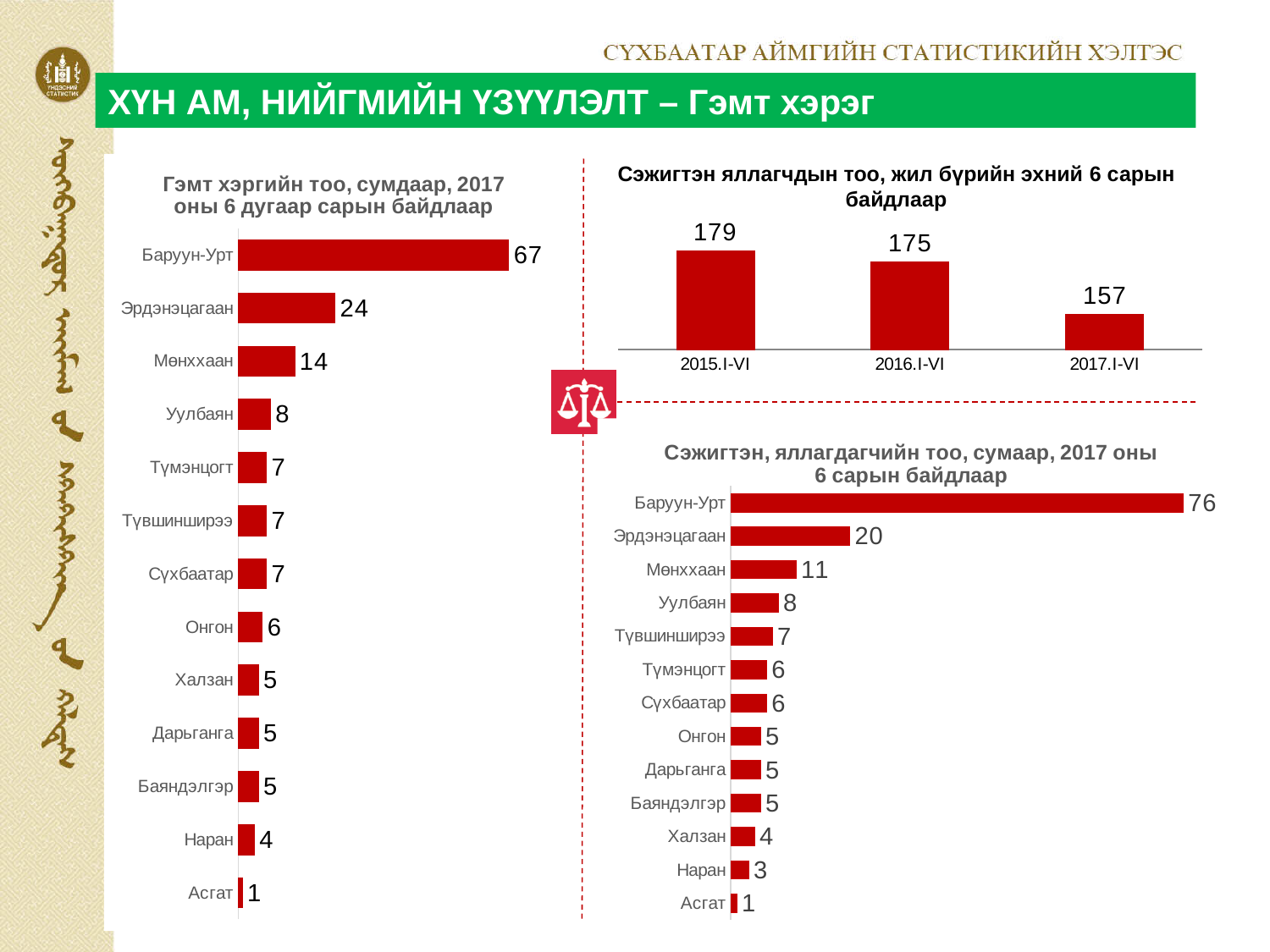
In the left chart 'Гэмт хэргийн тоо, сумдаар', how many sums are listed? 13 In the top right chart 'Сэжигтэн яллагчдын тоо', do the values rise or fall from 2015.I-VI to 2017.I-VI? fall In the left chart 'Гэмт хэргийн тоо, сумдаар, 2017 оны 6 дугаар сарын байдлаар', what is the value for Баруун-Урт? 67 In the left chart 'Гэмт хэргийн тоо, сумдаар', what is the value for Мөнххаан? 14 What kind of chart is the top right chart 'Сэжигтэн яллагчдын тоо, жил бүрийн эхний 6 сарын байдлаар'? bar chart In the top right chart 'Сэжигтэн яллагчдын тоо', what is the difference between 2015.I-VI and 2017.I-VI? 22 In the left chart 'Гэмт хэргийн тоо, сумдаар', which sum has the lowest value? Асгат In the bottom right chart 'Сэжигтэн, яллагдагчийн тоо, сумаар', which is larger, Мөнххаан or Уулбаян? Мөнххаан In the top right chart 'Сэжигтэн яллагчдын тоо, жил бүрийн эхний 6 сарын байдлаар', what is the value for 2016.I-VI? 175 In the bottom right chart 'Сэжигтэн, яллагдагчийн тоо, сумаар', what is the value for Наран? 3 In the bottom right chart 'Сэжигтэн, яллагдагчийн тоо, сумаар, 2017 оны 6 сарын байдлаар', what is the value for Баруун-Урт? 76 In the left chart 'Гэмт хэргийн тоо, сумдаар', what is the difference between Баруун-Урт and Эрдэнэцагаан? 43